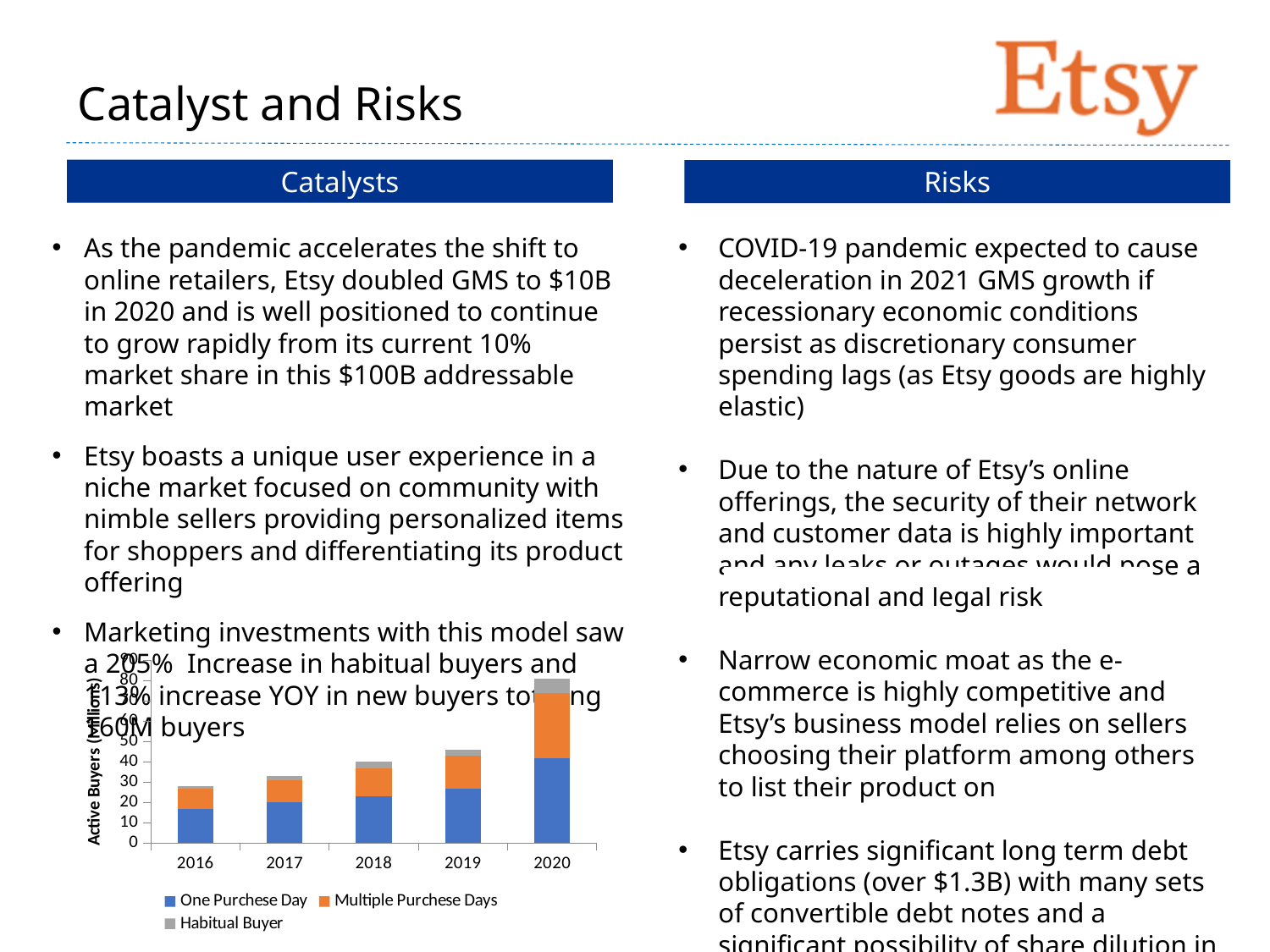
How many series does the chart's legend list? 3 Which year has the lowest total active buyers in the chart? 2016 Is the One Purchase Day value for 2020 greater or less than 30? greater Do total active buyers rise or fall from 2016 to 2020 in the chart? Rise Which series is shown in orange in the chart? Multiple Purchese Days How many years are shown on the x axis of the chart? 5 Is the total active buyers value for 2020 greater or less than 70? greater What kind of chart is shown on the slide? Stacked bar chart Is the total active buyers value for 2019 greater or less than 40? greater Which year has the highest total active buyers in the chart? 2020 What is the label on the chart's y axis? Active Buyers (Millions)